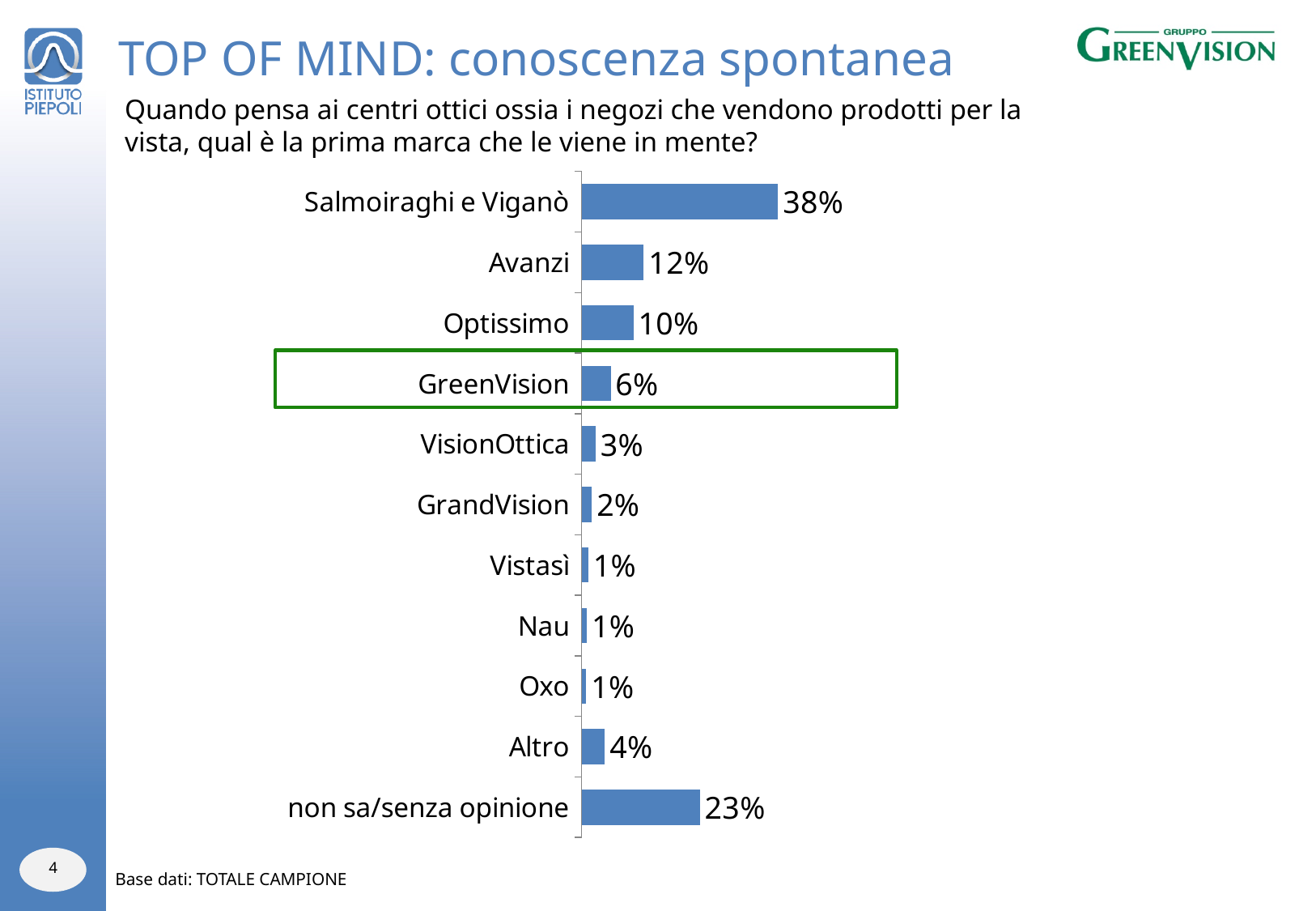
How many categories are shown in the chart? 11 What is the difference between the values for Optissimo and GreenVision? 4% What is the value for Optissimo? 10% Which category has the highest value? Salmoiraghi e Viganò Which category is highlighted with a green box? GreenVision What kind of chart is shown on the slide? Bar chart Which is larger, the value for VisionOttica or the value for GrandVision? VisionOttica Which is larger, the value for Avanzi or the value for Altro? Avanzi What is the value for non sa/senza opinione? 23% What is the difference between the values for Salmoiraghi e Viganò and Avanzi? 26% What is the value for Salmoiraghi e Viganò? 38% What is the value for GreenVision? 6%